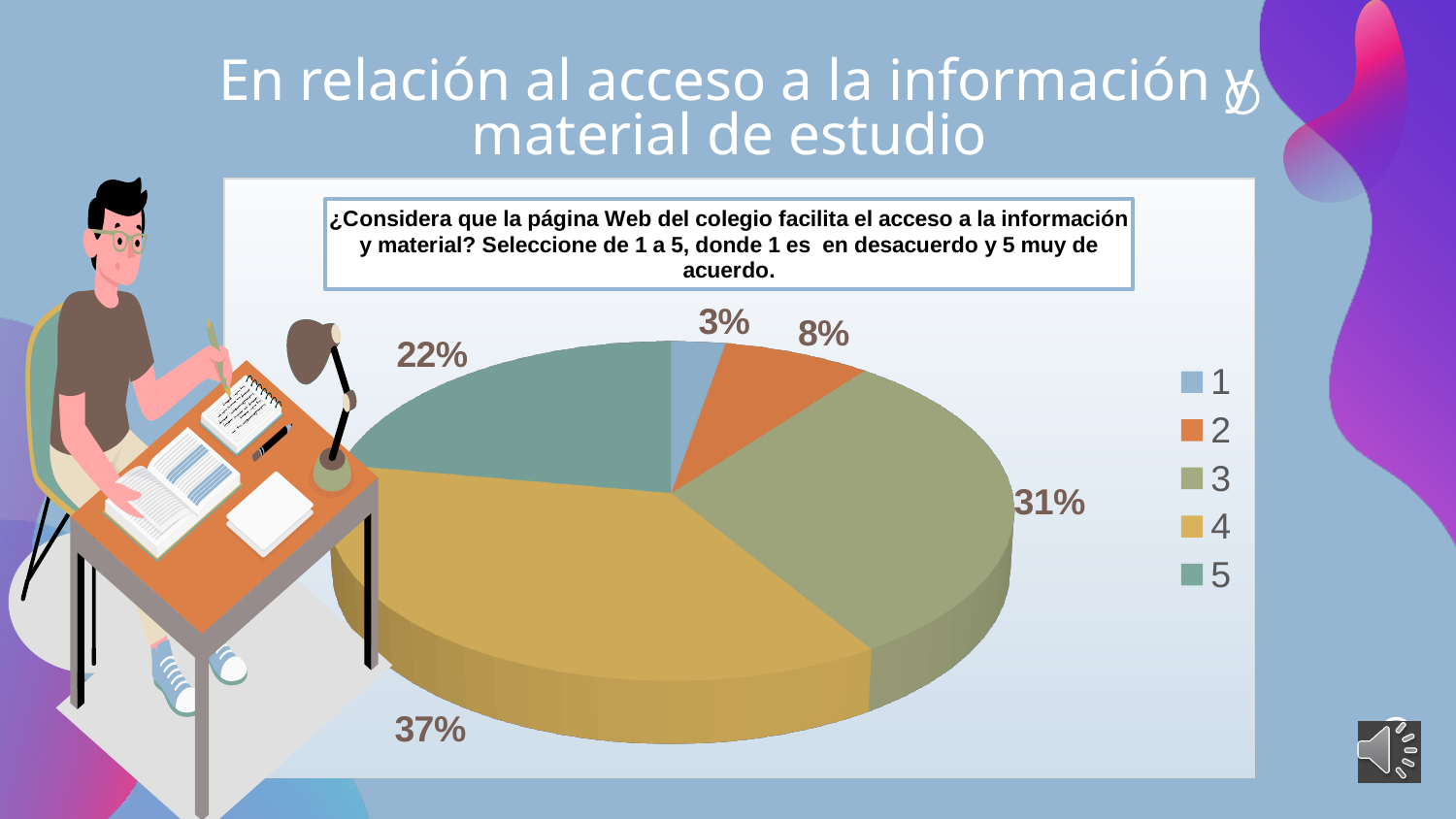
What percentage of respondents selected 2? 8% Which response option has the largest share of the pie? 4 What percentage of respondents selected 4? 37% What is the difference in percentage points between the shares for 4 and 3? 6 What percentage of respondents selected 3? 31% How many entries does the legend list? 5 What percentage of respondents selected 5? 22% Which response option has the smallest share of the pie? 1 Which has a larger share, response 5 or response 2? 5 What type of chart is shown on the slide? Pie chart How many slices does the pie chart have? 5 What percentage of respondents selected 1? 3%